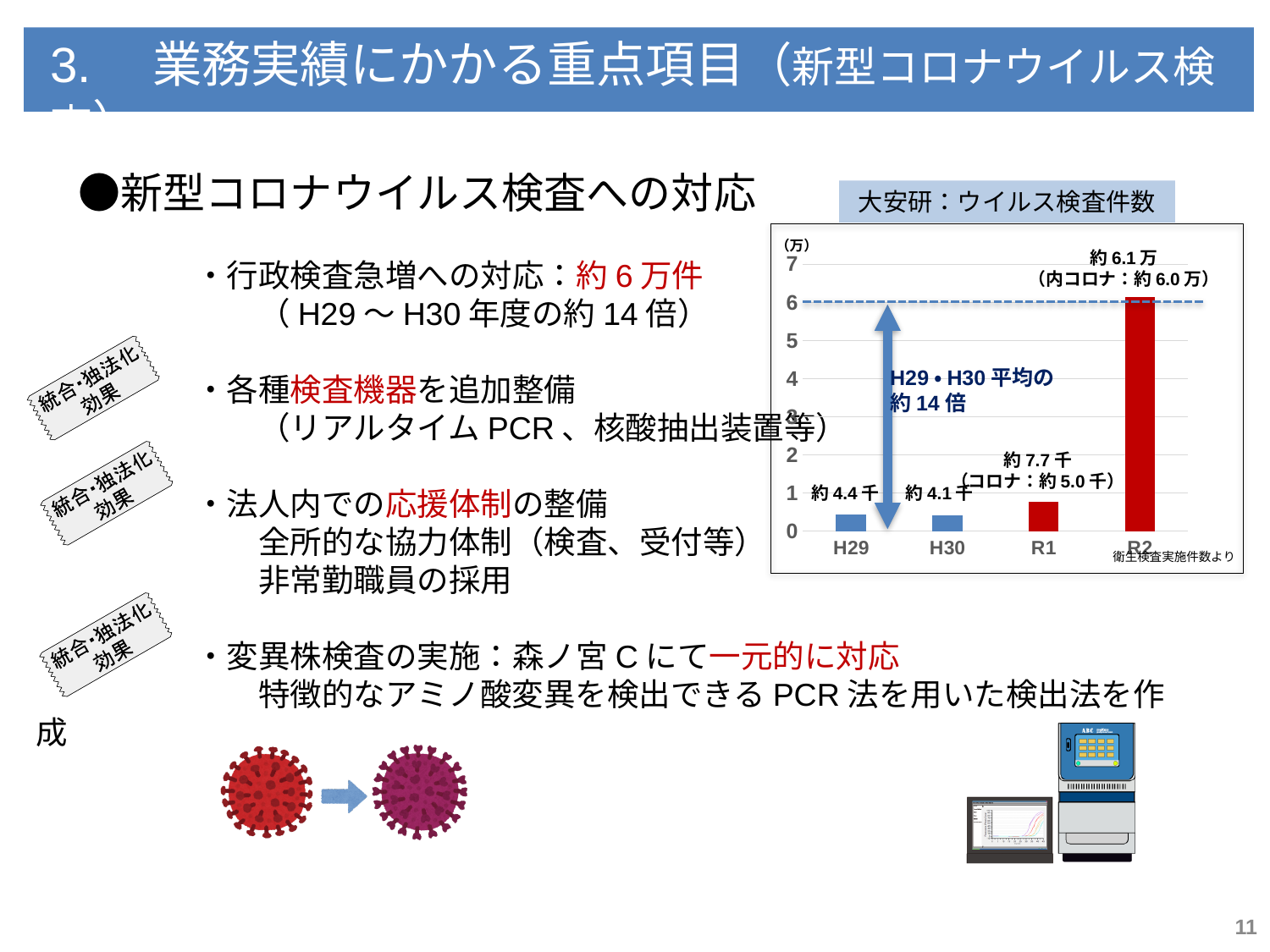
What is the data label for R2 in the chart? 約6.1万 Which category has the highest value in the chart? R2 Which category has the lowest value in the chart? H30 What is the title of the chart on the slide? 大安研：ウイルス検査件数 How many categories are shown on the x axis of the chart? 4 What is the data label for H30 in the chart? 約4.1千 What is the unit shown at the top of the y axis of the chart? 万 What is the data label for R1 in the chart? 約7.7千 Which is larger in the chart, the value for R1 or the value for H29? R1 Is the value for R1 greater or less than 1 (万) on the chart's axis? less What type of chart is shown under the title 大安研：ウイルス検査件数? bar chart What is the data label for H29 in the chart? 約4.4千